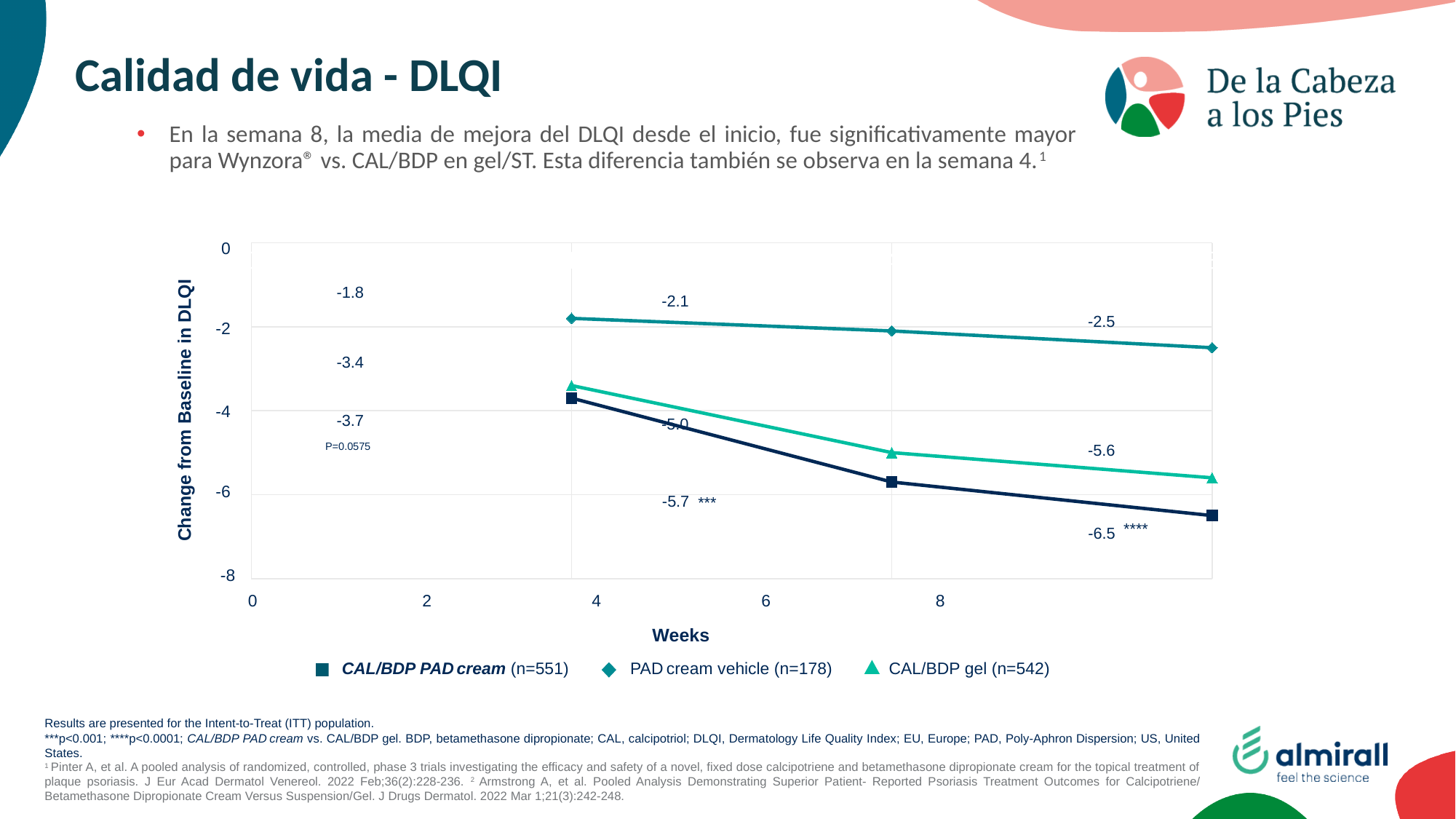
At the final time point, what is the difference between the CAL/BDP gel value (-5.6) and the CAL/BDP PAD cream value (-6.5)? 0.9 What is the final (rightmost) value for CAL/BDP gel (n=542)? -5.6 How many series does the legend list? 3 What is the title of the y axis? Change from Baseline in DLQI What is the final (rightmost) value for CAL/BDP PAD cream (n=551)? -6.5 What kind of chart is shown on the slide? Line chart At the final time point, which series has the lowest (most negative) change from baseline in DLQI? CAL/BDP PAD cream (n=551) What is the final (rightmost) value for PAD cream vehicle (n=178)? -2.5 How many data points are plotted for each series? 3 Do the values for CAL/BDP PAD cream rise or fall along the x axis? Fall What is the first plotted value for CAL/BDP PAD cream (n=551)? -3.7 What is the middle plotted value for CAL/BDP gel (n=542)? -5.0